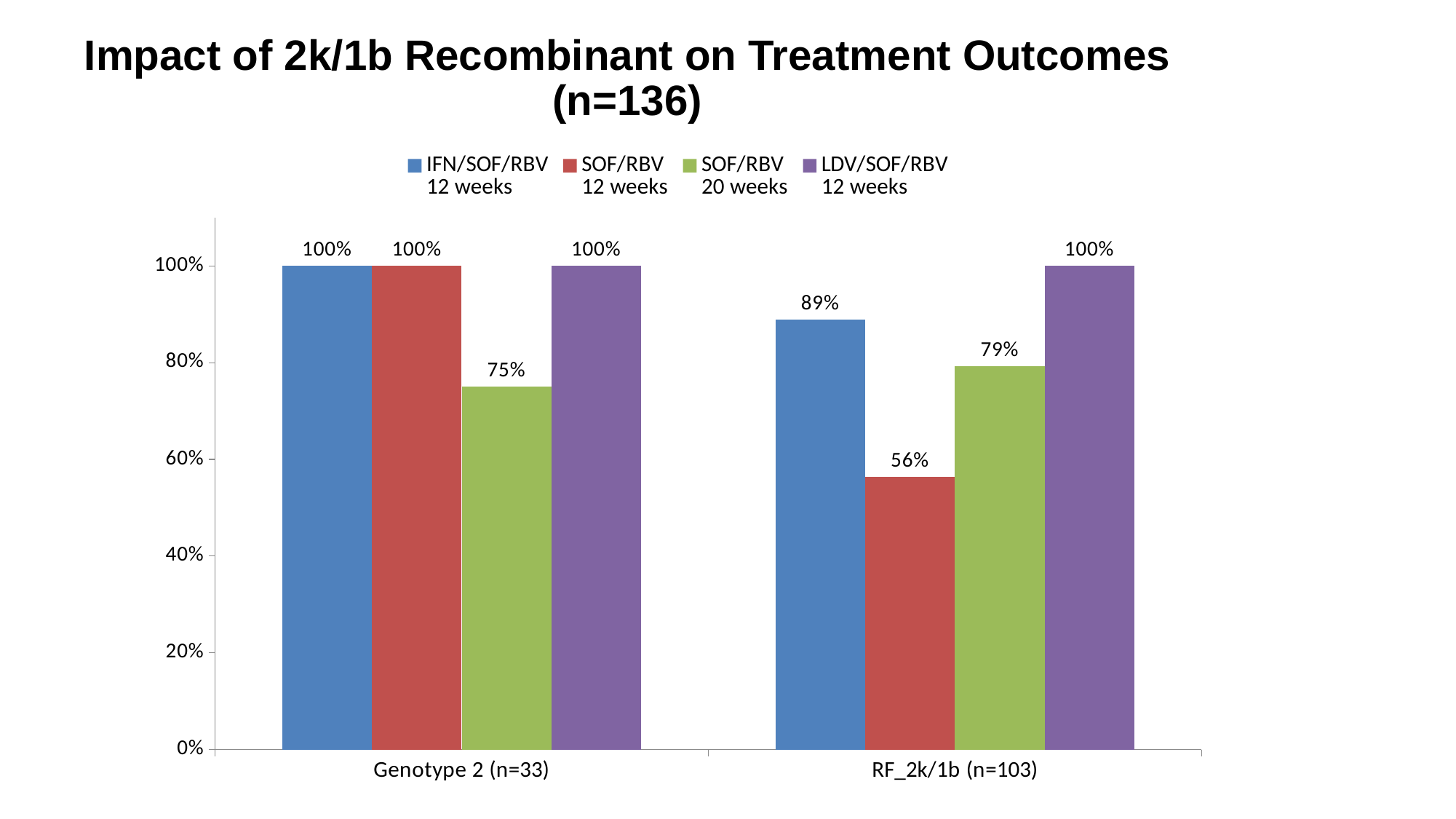
How many series does the legend list? 4 Which series has the lowest value in the RF_2k/1b (n=103) group? SOF/RBV 12 weeks What is the value for SOF/RBV 20 weeks in the Genotype 2 (n=33) group? 75% What is the difference between the IFN/SOF/RBV 12 weeks and SOF/RBV 20 weeks values in the RF_2k/1b (n=103) group? 10% Which series has the lowest value in the Genotype 2 (n=33) group? SOF/RBV 20 weeks What kind of chart is shown on the slide? Bar chart What is the difference between the SOF/RBV 12 weeks values for Genotype 2 (n=33) and RF_2k/1b (n=103)? 44% How many categories are shown on the x axis? 2 What is the value for SOF/RBV 12 weeks in the RF_2k/1b (n=103) group? 56% What is the value for IFN/SOF/RBV 12 weeks in the RF_2k/1b (n=103) group? 89% Which is larger in the RF_2k/1b (n=103) group: IFN/SOF/RBV 12 weeks or SOF/RBV 20 weeks? IFN/SOF/RBV 12 weeks What is the value for LDV/SOF/RBV 12 weeks in the RF_2k/1b (n=103) group? 100%